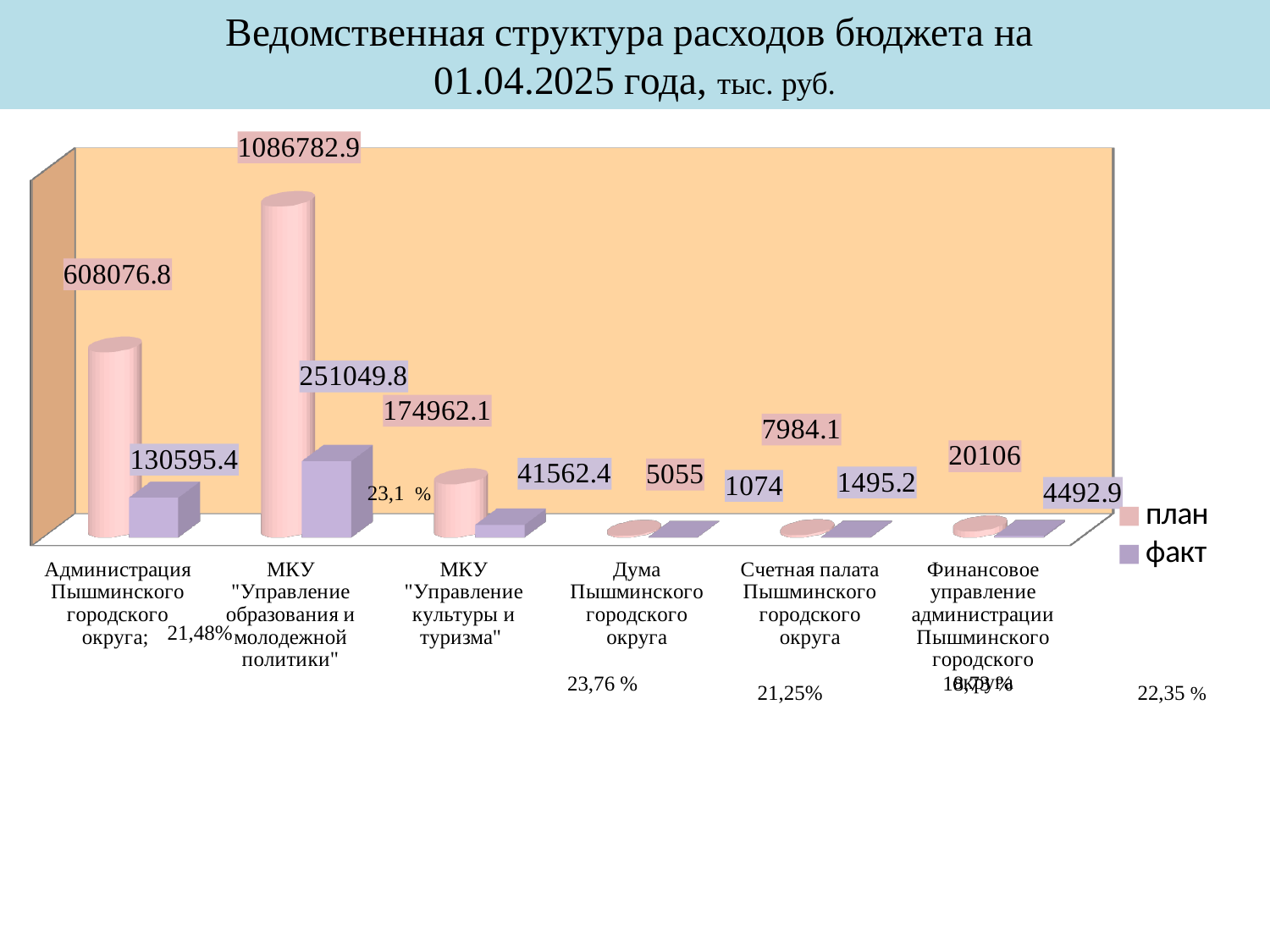
What is the difference between the план and факт values for Дума Пышминского городского округа? 3981 What kind of chart is shown on the slide? Bar chart What is the difference between the план and факт values for Финансовое управление администрации Пышминского городского округа? 15613.1 What is the факт value for Счетная палата Пышминского городского округа? 1495.2 What is the факт value for Администрация Пышминского городского округа? 130595.4 What is the план value for МКУ "Управление образования и молодежной политики"? 1086782.9 How many categories are shown on the x axis? 6 What is the план value for Дума Пышминского городского округа? 5055 How many series does the legend list? 2 Which category has the lowest факт value? Дума Пышминского городского округа Which is larger: the план value for Счетная палата Пышминского городского округа or the план value for Финансовое управление администрации Пышминского городского округа? Финансовое управление администрации Пышминского городского округа Which category has the highest план value? МКУ "Управление образования и молодежной политики"